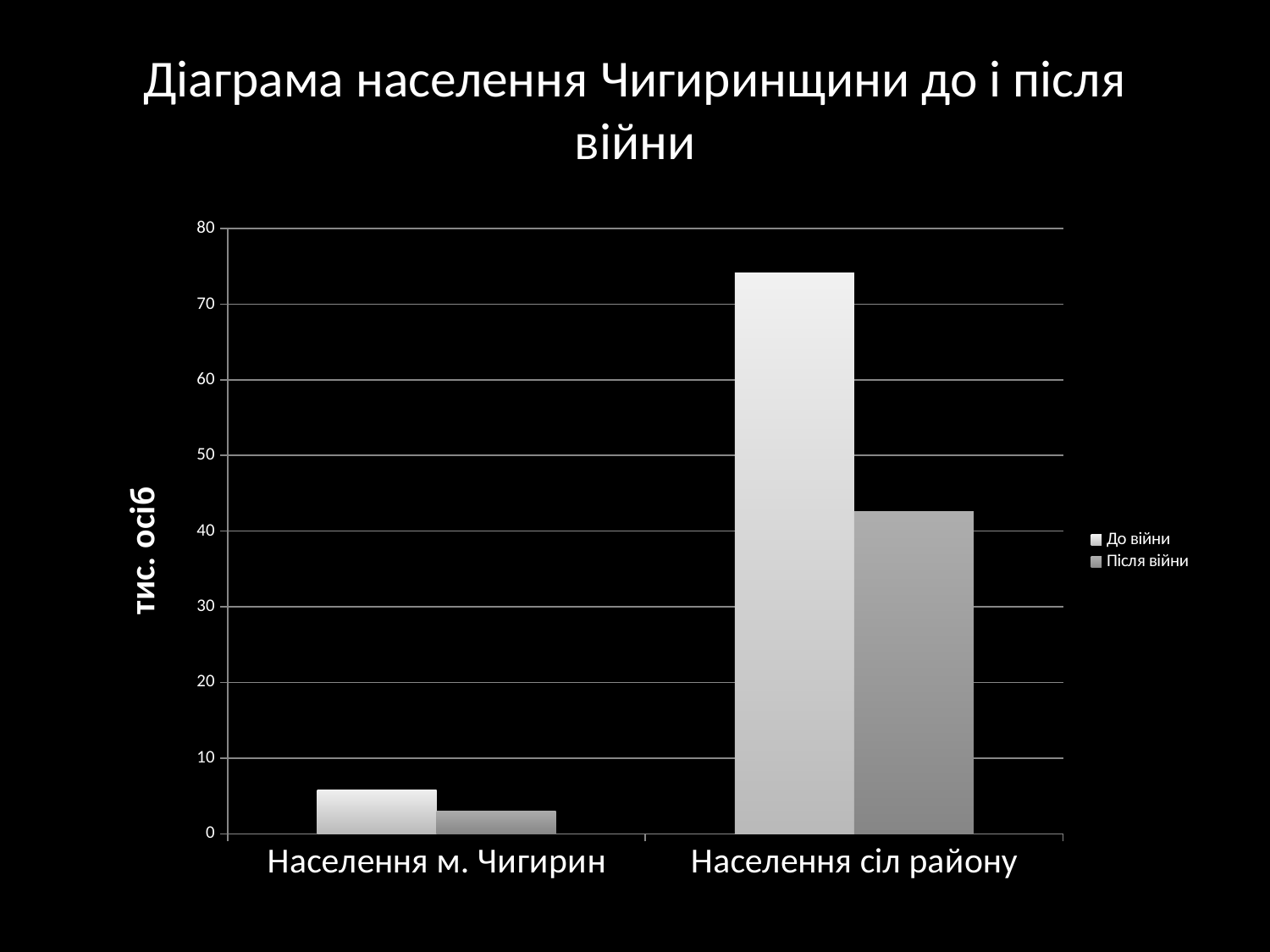
Is the value for Населення сіл району in the До війни series greater or less than 70? greater How many series does the legend list? 2 What is the label of the vertical axis? тис. осіб Which category has the lowest value in the Після війни series? Населення м. Чигирин How many categories are shown on the x axis? 2 Is the value for Населення м. Чигирин in the До війни series greater or less than 10? less Is the value for Населення сіл району in the Після війни series greater or less than 50? less What kind of chart is shown on the slide? bar chart What is the title of the chart? Діаграма населення Чигиринщини до і після війни Which category has the highest value in the До війни series? Населення сіл району For Населення сіл району, which series has the larger value, До війни or Після війни? До війни